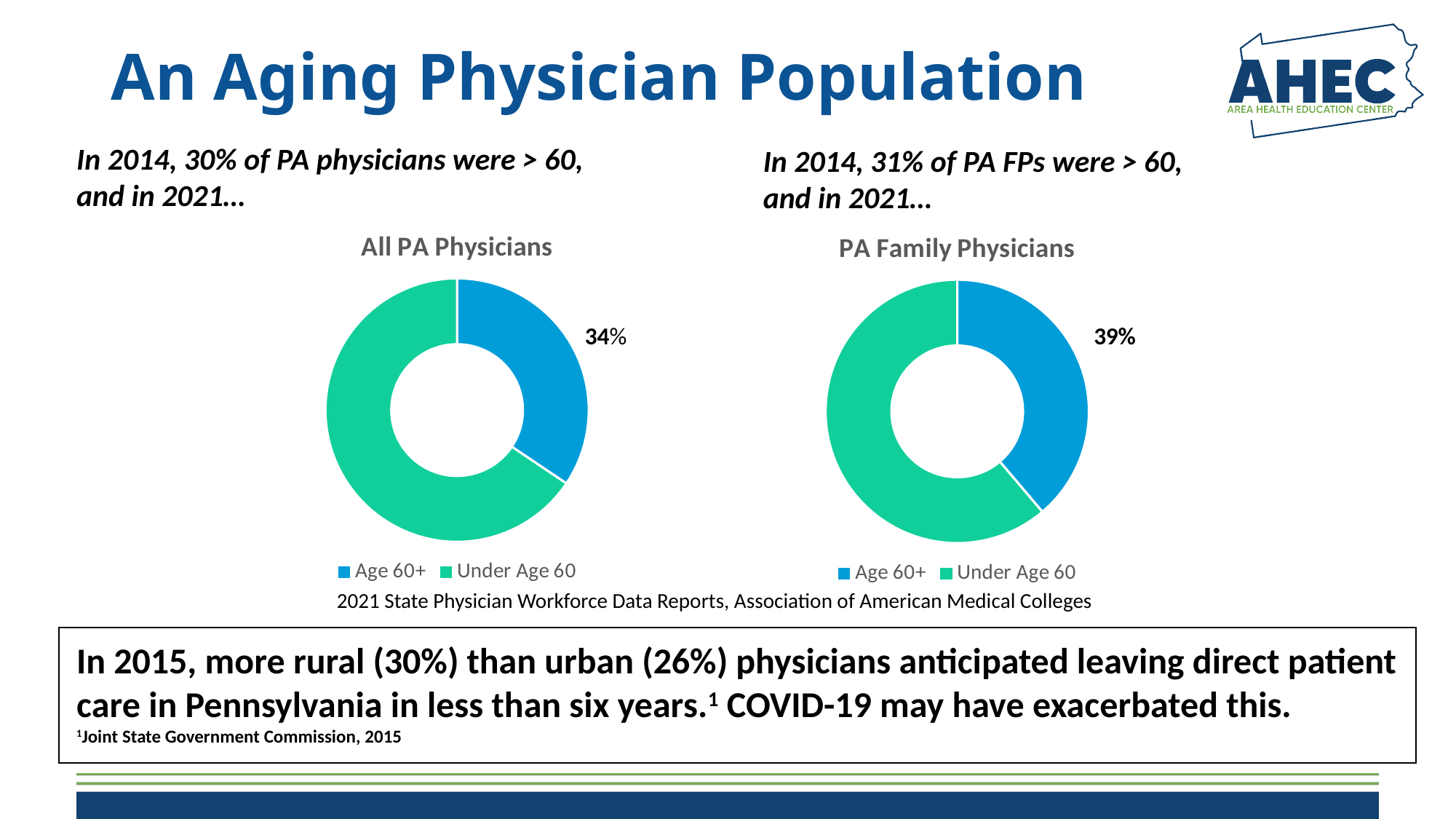
What type of chart is used for 'All PA Physicians'? Donut (pie) chart How many donut charts are shown on the slide? 2 In the 'All PA Physicians' chart, what percentage of physicians are Age 60+? 34% What is the difference in the Age 60+ share between the 'PA Family Physicians' chart and the 'All PA Physicians' chart? 5 percentage points In the 'PA Family Physicians' chart, which category is the smallest slice? Age 60+ How many categories does the legend of the 'PA Family Physicians' chart list? 2 In the 'PA Family Physicians' chart, what percentage of physicians are Age 60+? 39% In the 'All PA Physicians' chart, what share of the donut does the Age 60+ slice represent? 34% In the 'All PA Physicians' chart, which category is the largest slice? Under Age 60 What is the title of the chart on the right? PA Family Physicians Which chart shows a larger Age 60+ share, 'All PA Physicians' or 'PA Family Physicians'? PA Family Physicians What colour represents 'Under Age 60' in both charts? Green